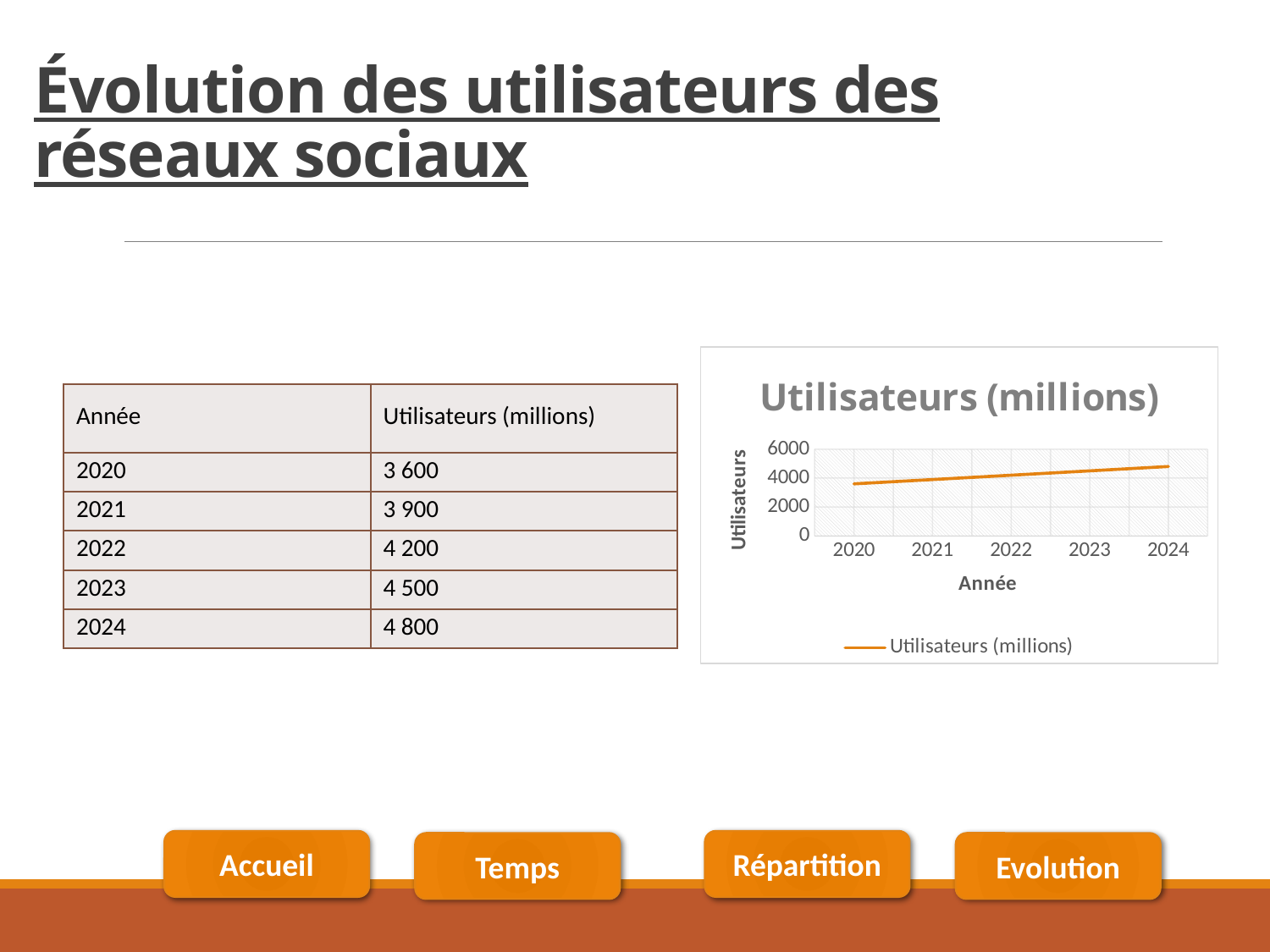
Is the value for 2024 in the chart greater or less than 4000? greater How many years are plotted along the x axis of the chart? 5 Is the value for 2020 in the chart greater or less than 4000? less What is the value of Utilisateurs (millions) for 2022? 4 200 What is the title of the chart? Utilisateurs (millions) Which is larger, the value for 2021 or the value for 2023? 2023 What is the difference between the values for 2024 and 2020? 1 200 Which year has the highest value in the chart? 2024 Which year has the lowest value in the chart? 2020 Do the values in the chart rise or fall from 2020 to 2024? rise What kind of chart is shown on the slide? line chart How many series does the chart legend list? 1